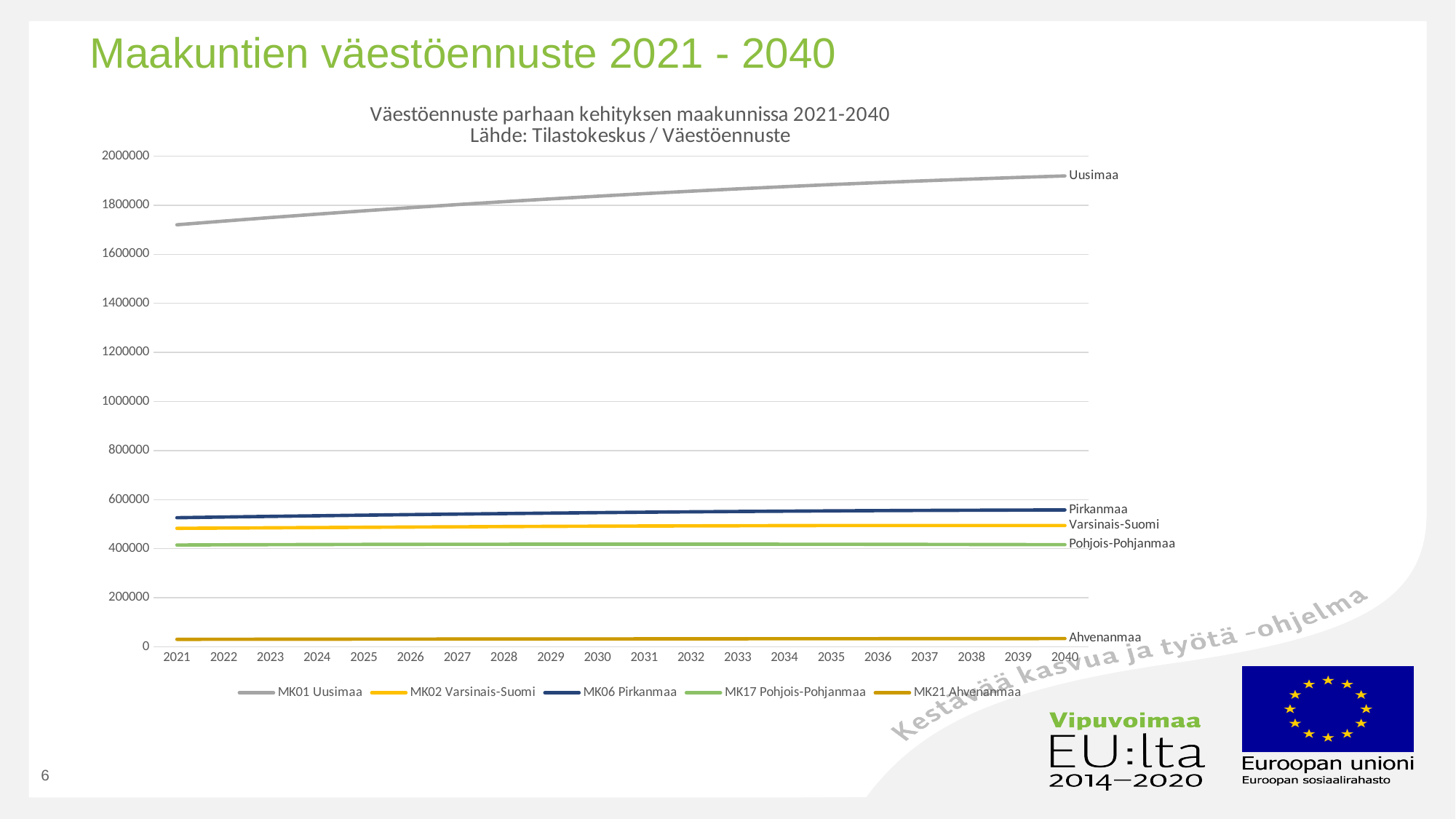
Does the Uusimaa line rise or fall from 2021 to 2040? rises What is the source named in the chart title? Tilastokeskus / Väestöennuste Is the value for Uusimaa in 2021 greater or less than 1800000? less Which region has the highest population throughout the forecast? Uusimaa How many years are shown along the x axis? 20 Is the value for Pirkanmaa in 2040 greater or less than 600000? less Is the value for Ahvenanmaa in 2030 greater or less than 200000? less Which is larger in 2040, the value for Pirkanmaa or the value for Varsinais-Suomi? Pirkanmaa What kind of chart is shown on the slide? line chart How many series does the legend list? 5 Which region has the lowest population throughout the forecast? Ahvenanmaa